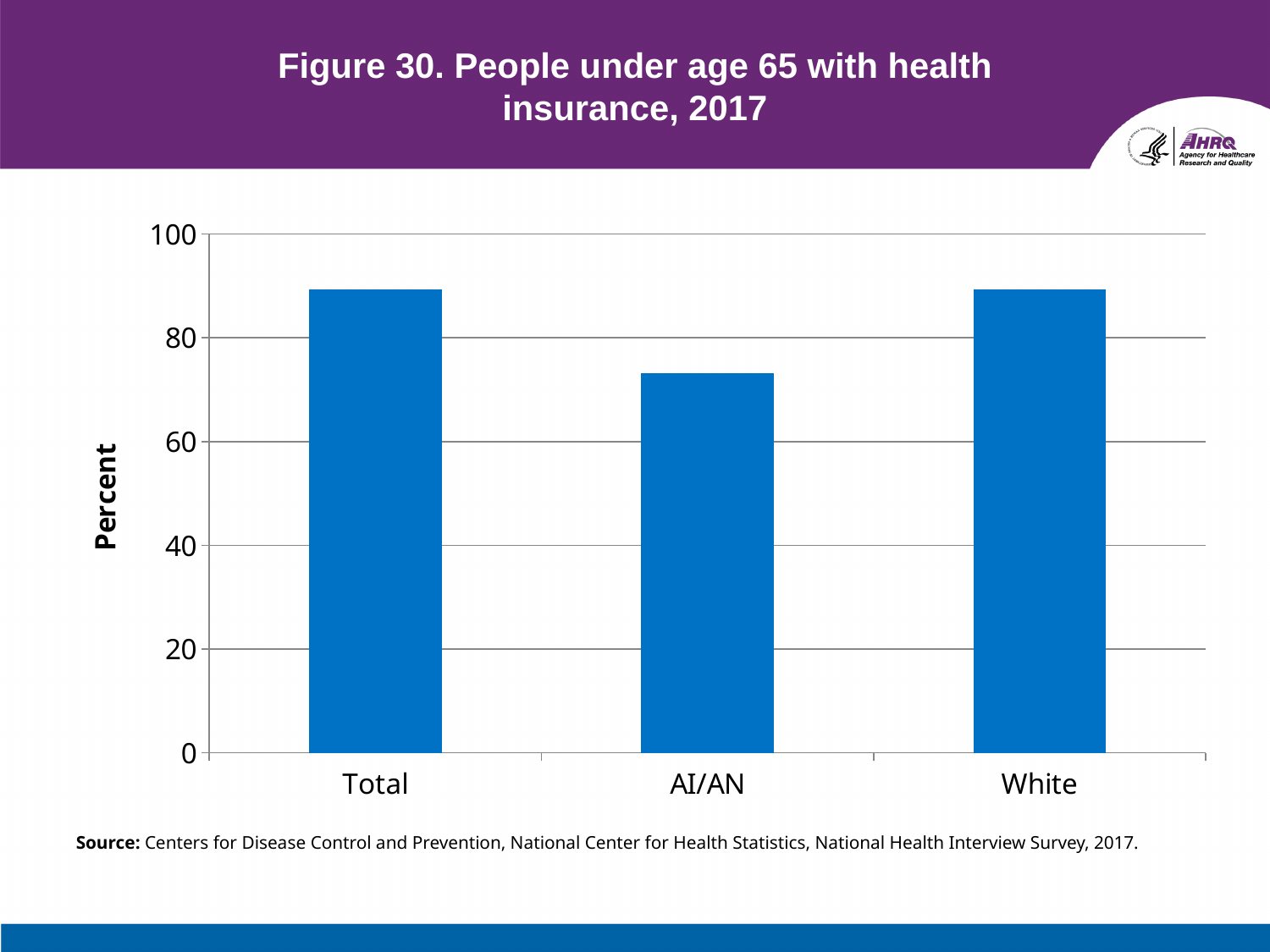
Which category has the lowest value in the chart? AI/AN Which is larger, the value for AI/AN or the value for White? White What is the title of the chart on the slide? Figure 30. People under age 65 with health insurance, 2017 What is the label on the y axis of the chart? Percent Is the value for AI/AN greater or less than 80? less Is the value for AI/AN greater or less than 60? greater Is the value for White greater or less than 80? greater What kind of chart is shown on the slide? bar chart Which is larger, the value for Total or the value for AI/AN? Total How many categories are shown on the x axis of the chart? 3